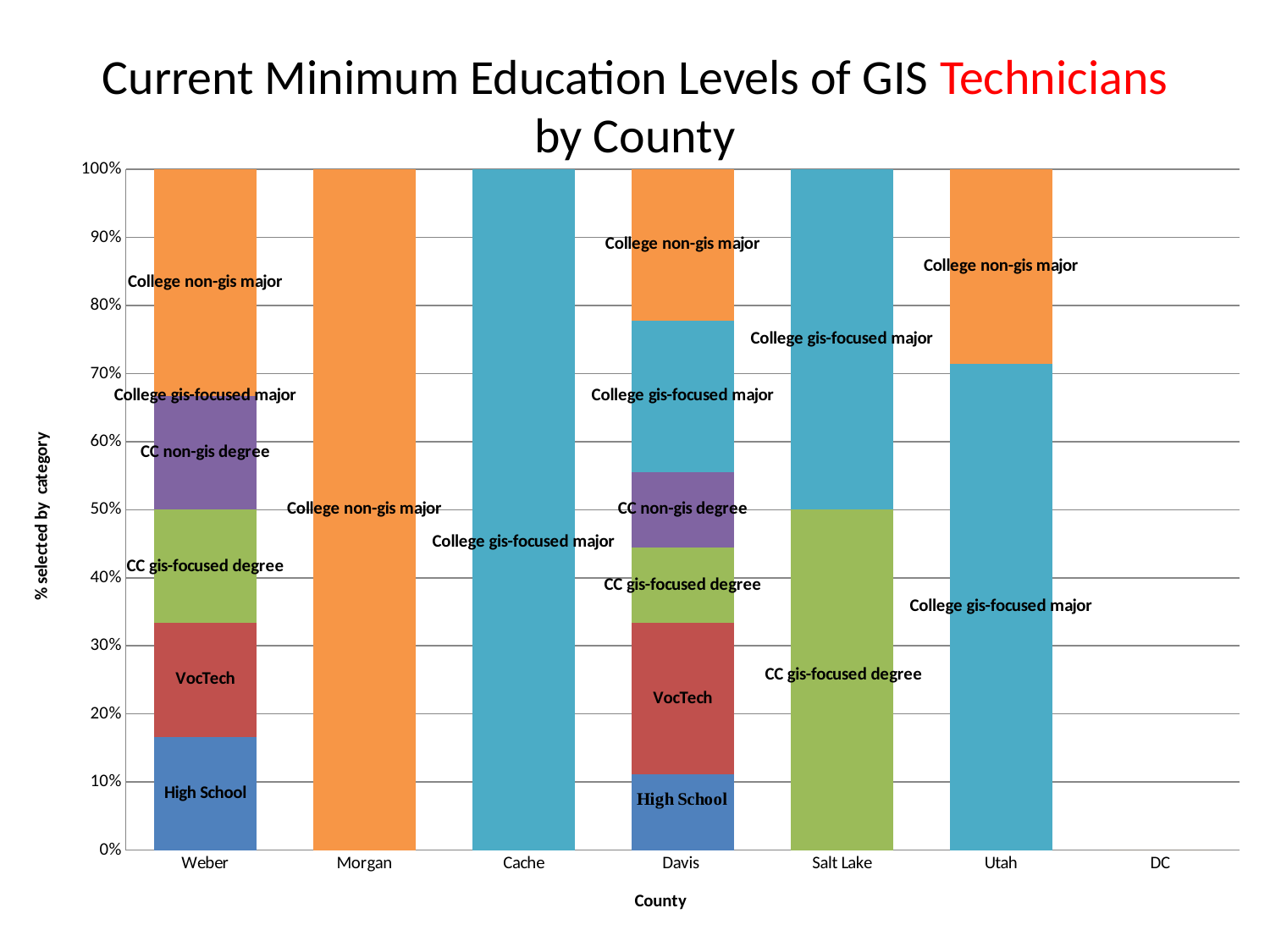
What is the title of the y axis? % selected by category What percentage does CC gis-focused degree account for in Salt Lake? 50% Is the High School share for Davis greater or less than 20%? less How many counties are listed along the x axis? 7 Which single education category makes up the entire bar for Morgan? College non-gis major What type of chart is shown on the slide? Stacked bar chart Which county on the x axis has no bar plotted? DC Which single education category makes up the entire bar for Cache? College gis-focused major What percentage does College gis-focused major account for in Salt Lake? 50% Is the College gis-focused major share for Utah greater or less than 60%? greater Is the High School share for Weber greater or less than 20%? less Which county has a larger High School share, Weber or Davis? Weber